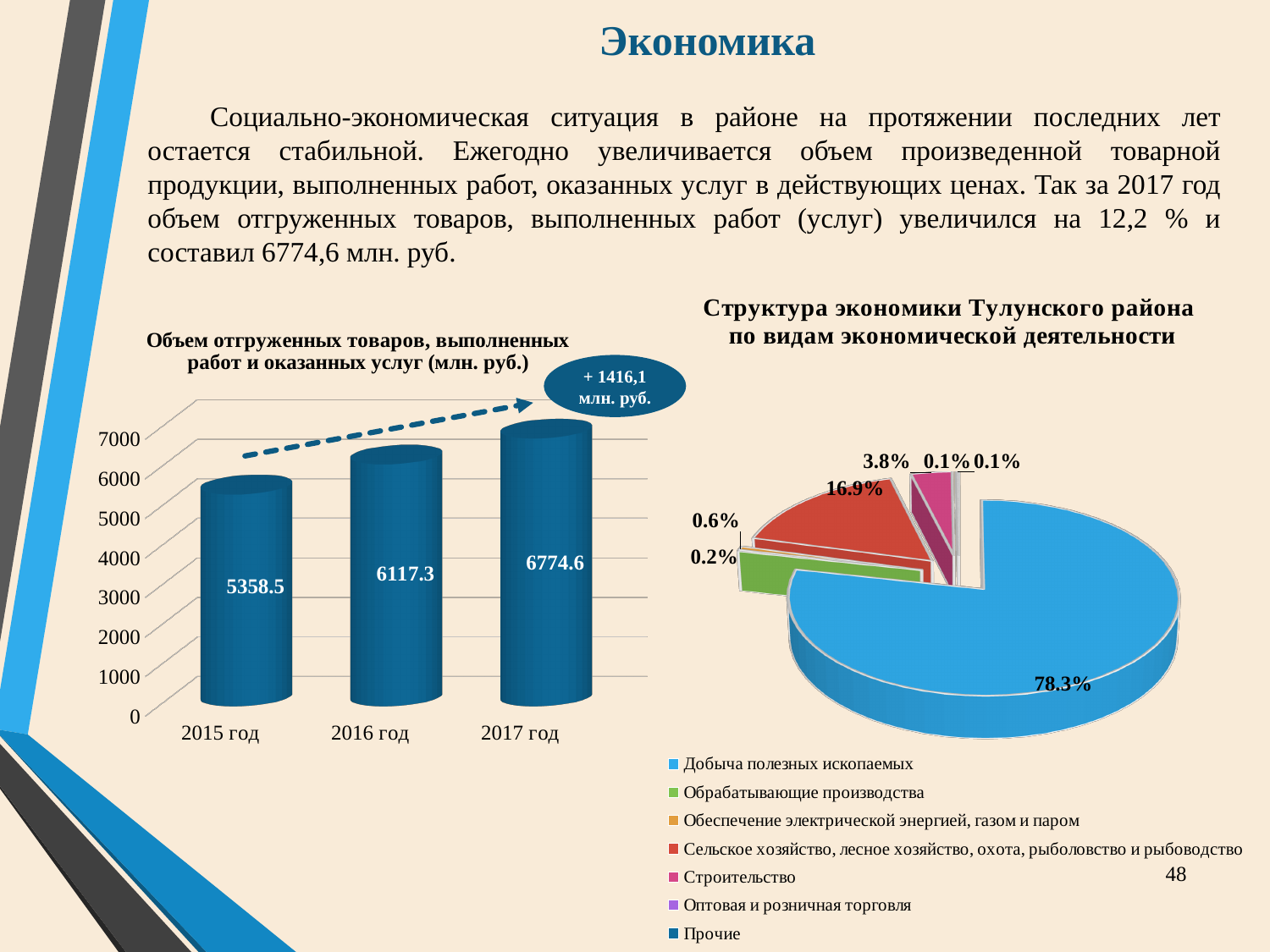
In the bar chart on the left, do the values rise or fall from 2015 год to 2017 год? rise In the pie chart 'Структура экономики Тулунского района по видам экономической деятельности', what share does the red slice (Сельское хозяйство, лесное хозяйство, охота, рыболовство и рыбоводство) have? 16.9% How many categories does the legend of the pie chart on the right list? 7 In the bar chart on the left, which year has the highest value? 2017 год In the bar chart on the left, what is the difference between the values for 2016 год and 2015 год? 758.8 In the pie chart 'Структура экономики Тулунского района по видам экономической деятельности', what share does the largest slice (Добыча полезных ископаемых) have? 78.3% In the bar chart 'Объем отгруженных товаров, выполненных работ и оказанных услуг (млн. руб.)', what is the value for 2016 год? 6117.3 How many years are shown in the bar chart on the left? 3 In the bar chart 'Объем отгруженных товаров, выполненных работ и оказанных услуг (млн. руб.)', what is the value for 2015 год? 5358.5 In the bar chart on the left, what is the difference between the values for 2017 год and 2015 год? 1416.1 In the bar chart 'Объем отгруженных товаров, выполненных работ и оказанных услуг (млн. руб.)', what is the value for 2017 год? 6774.6 In the bar chart on the left, which year has the lowest value? 2015 год